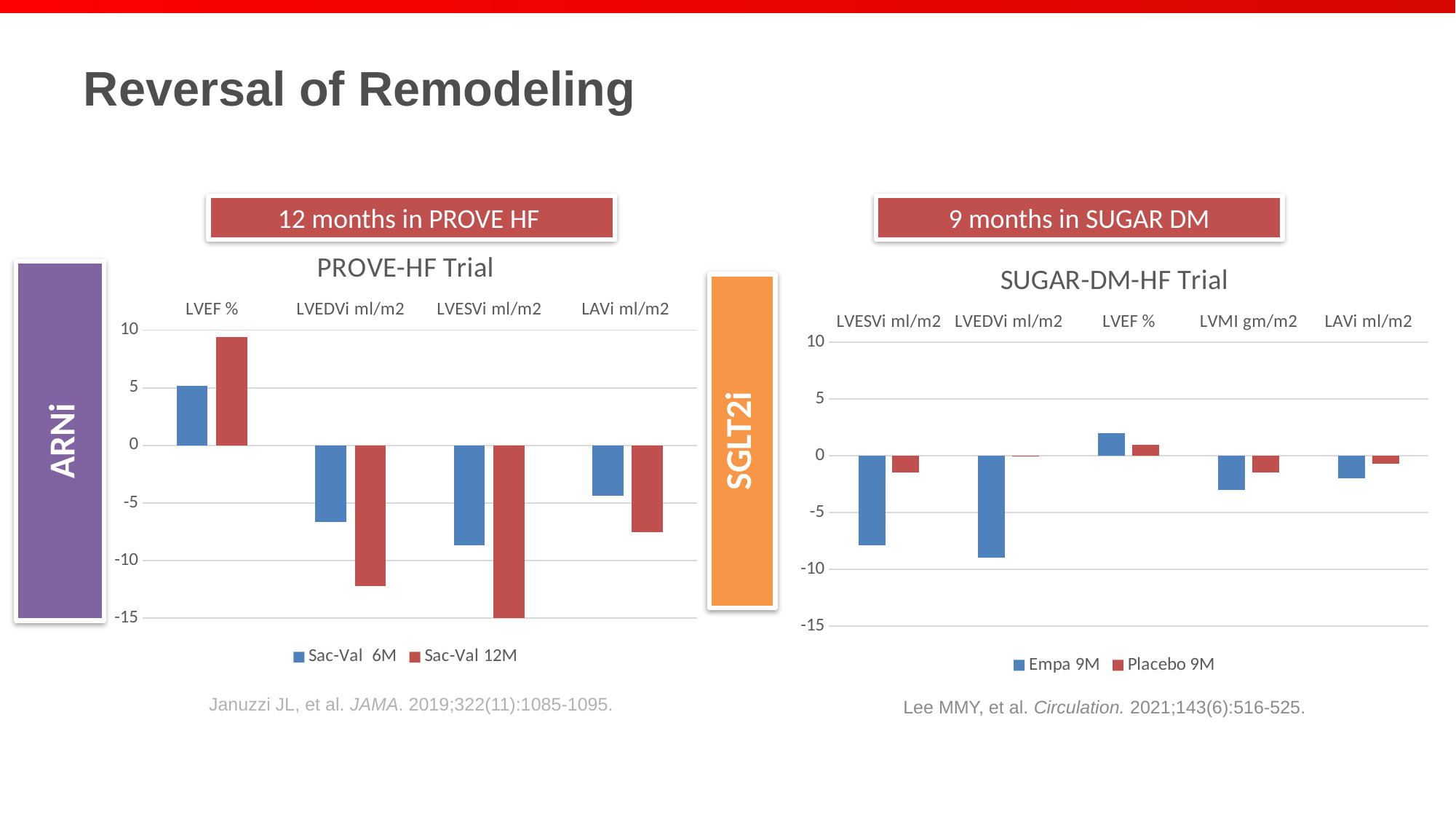
In the SUGAR-DM-HF Trial chart, which series has the lower value for LVESVi ml/m2, Empa 9M or Placebo 9M? Empa 9M How many categories are shown on the x axis of the SUGAR-DM-HF Trial chart? 5 In the PROVE-HF Trial chart, is the Sac-Val 12M value for LVEF % greater or less than 5? greater In the SUGAR-DM-HF Trial chart, is the Empa 9M value for LVEDVi ml/m2 greater or less than -5? less In the PROVE-HF Trial chart, which series has the lower value for LVESVi ml/m2, Sac-Val 6M or Sac-Val 12M? Sac-Val 12M What are the two legend entries of the SUGAR-DM-HF Trial chart? Empa 9M and Placebo 9M What kind of chart is the PROVE-HF Trial chart? Bar chart In the PROVE-HF Trial chart, which bar has the highest value? Sac-Val 12M for LVEF % In the PROVE-HF Trial chart, which bar has the lowest value? Sac-Val 12M for LVESVi ml/m2 How many series does the legend of the PROVE-HF Trial chart list? 2 How many categories are shown on the x axis of the PROVE-HF Trial chart? 4 In the PROVE-HF Trial chart, is the Sac-Val 12M value for LVEDVi ml/m2 greater or less than -10? less